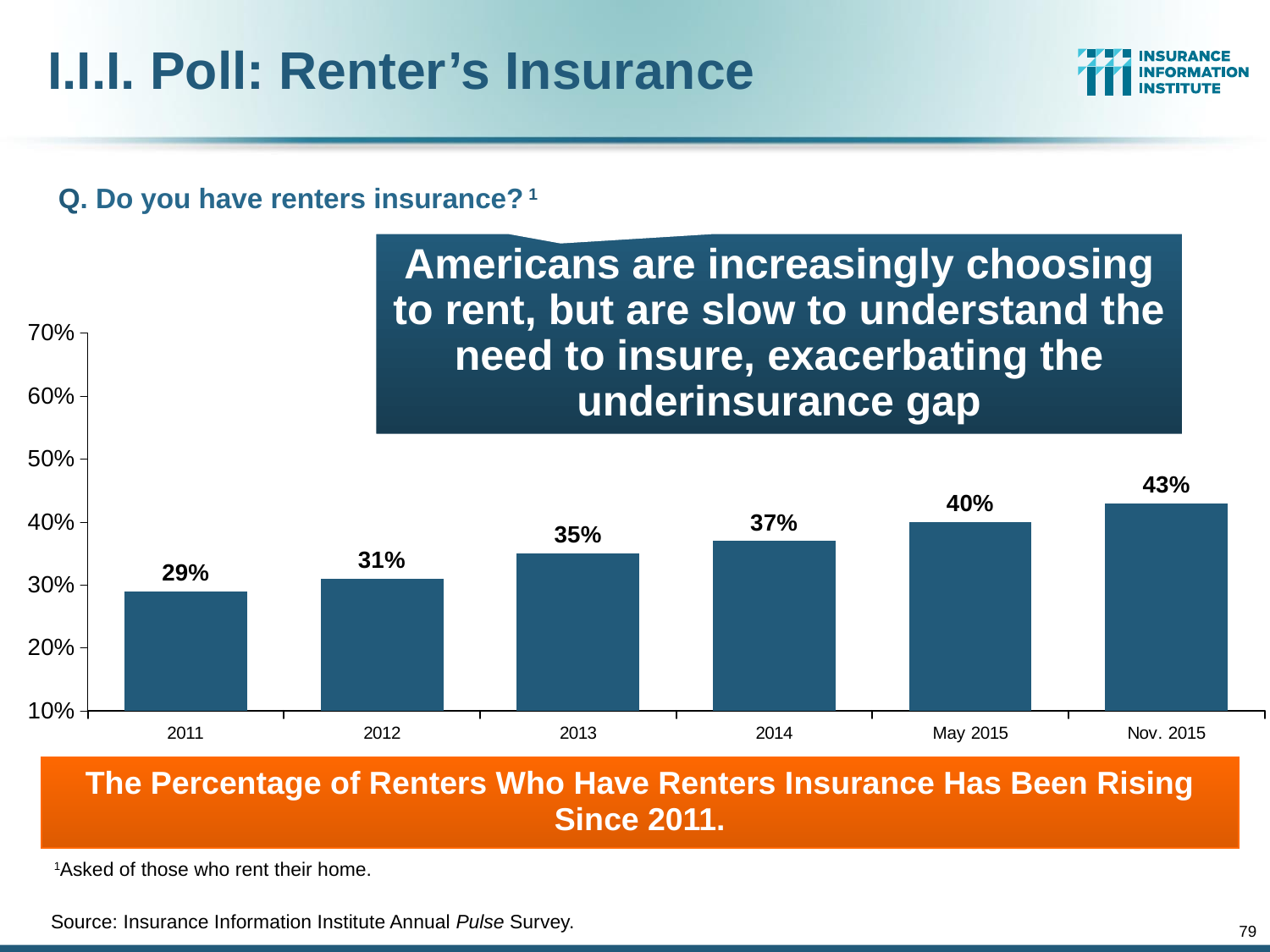
What is the value shown for May 2015? 40% How many periods are shown on the x axis of the chart? 6 By how many percentage points did the value increase from 2011 to Nov. 2015? 14 percentage points Which period has the lowest percentage of renters with renters insurance? 2011 Which is larger, the value for 2013 or the value for May 2015? May 2015 What is the value shown for 2013? 35% What percentage of renters had renters insurance in 2011? 29% Which period has the highest percentage of renters with renters insurance? Nov. 2015 Do the values rise or fall from 2011 to Nov. 2015? Rise What is the difference between the 2014 value and the 2012 value? 6 percentage points What is the value shown for Nov. 2015? 43% What kind of chart is used on this slide? Bar chart